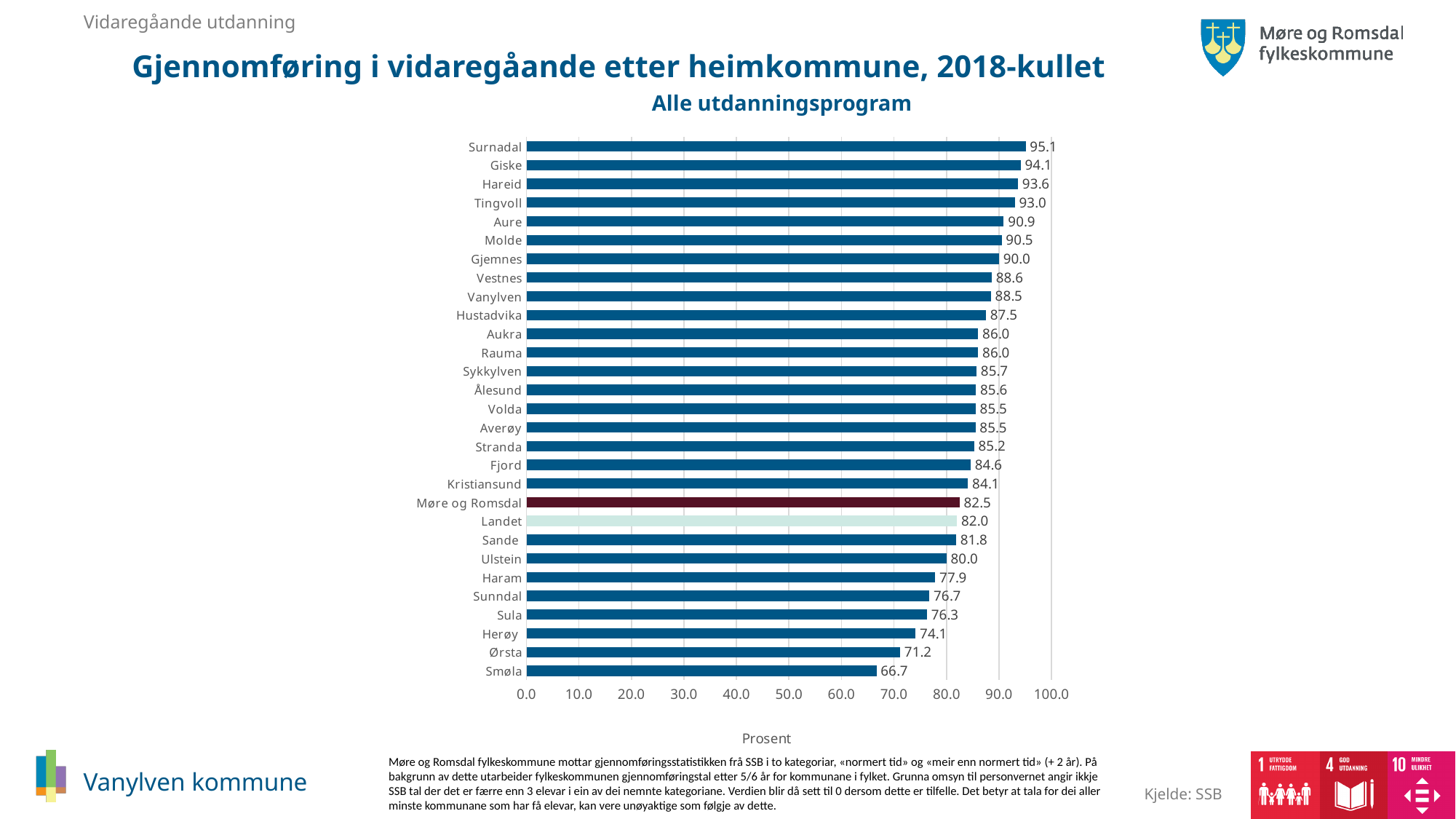
What is the label of the x axis? Prosent What is the difference between the values for Surnadal and Smøla? 28.4 What is the value for Landet? 82.0 What is the difference between the values for Vanylven and Landet? 6.5 What is the value for Møre og Romsdal? 82.5 Which category has the highest value? Surnadal Is the value for Ørsta greater or less than 80.0? less How many categories are shown on the chart? 29 Which is larger, the value for Molde or the value for Ålesund? Molde What is the value for Vanylven? 88.5 Which category has the lowest value? Smøla What kind of chart is shown on the slide? bar chart